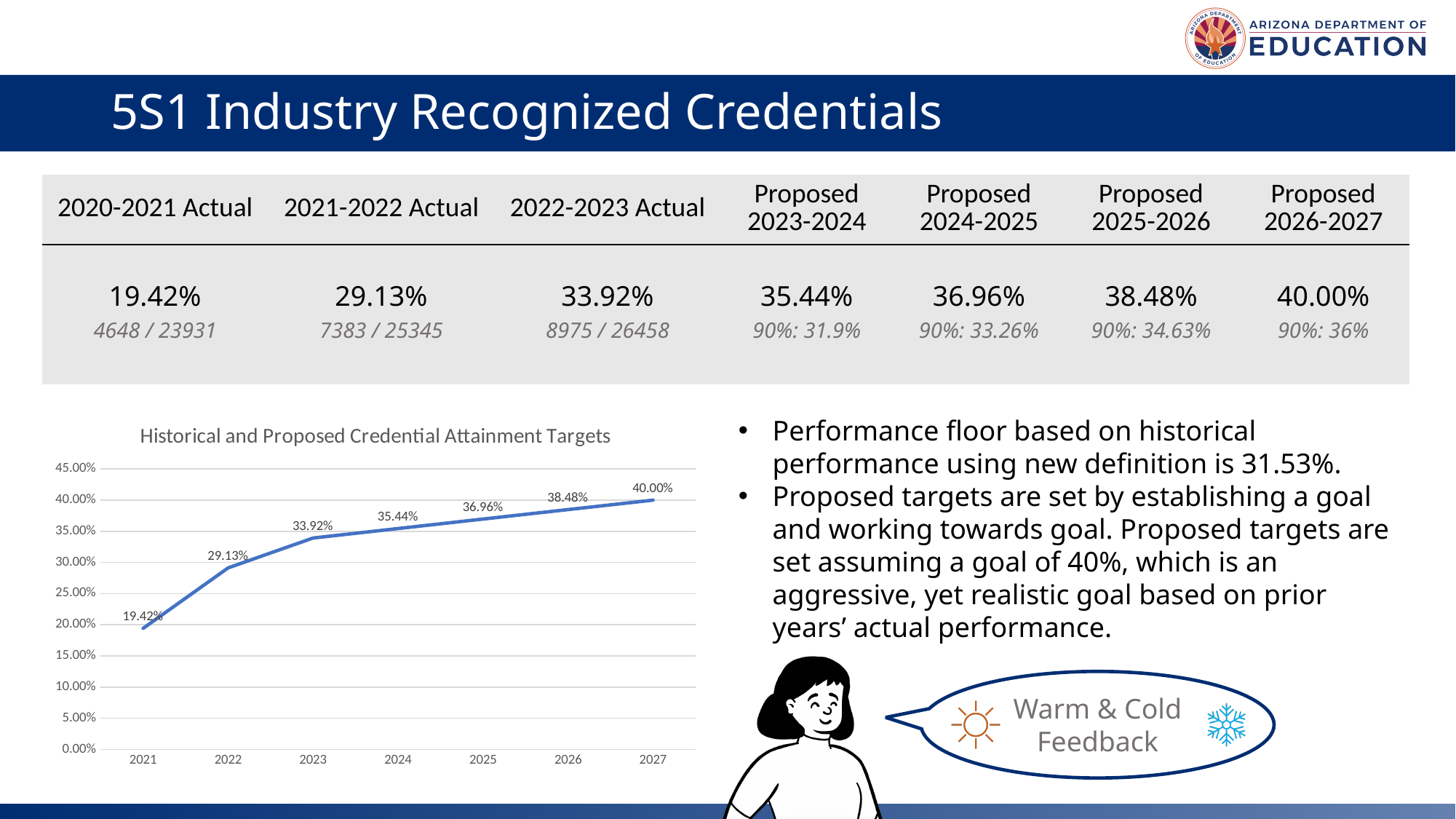
What is the title of the chart? Historical and Proposed Credential Attainment Targets Is the value for 2022 greater or less than 25.00%? greater What is the difference between the values for 2023 and 2022? 4.79% Which is larger, the value for 2025 or the value for 2023? 2025 Which year has the lowest value in the chart? 2021 What is the value for 2021 in the chart? 19.42% What is the value for 2027 in the chart? 40.00% What kind of chart is shown on the slide? line chart What is the value for 2024 in the chart? 35.44% How many years are plotted on the x axis of the chart? 7 Which year has the highest value in the chart? 2027 What is the difference between the values for 2027 and 2021? 20.58%